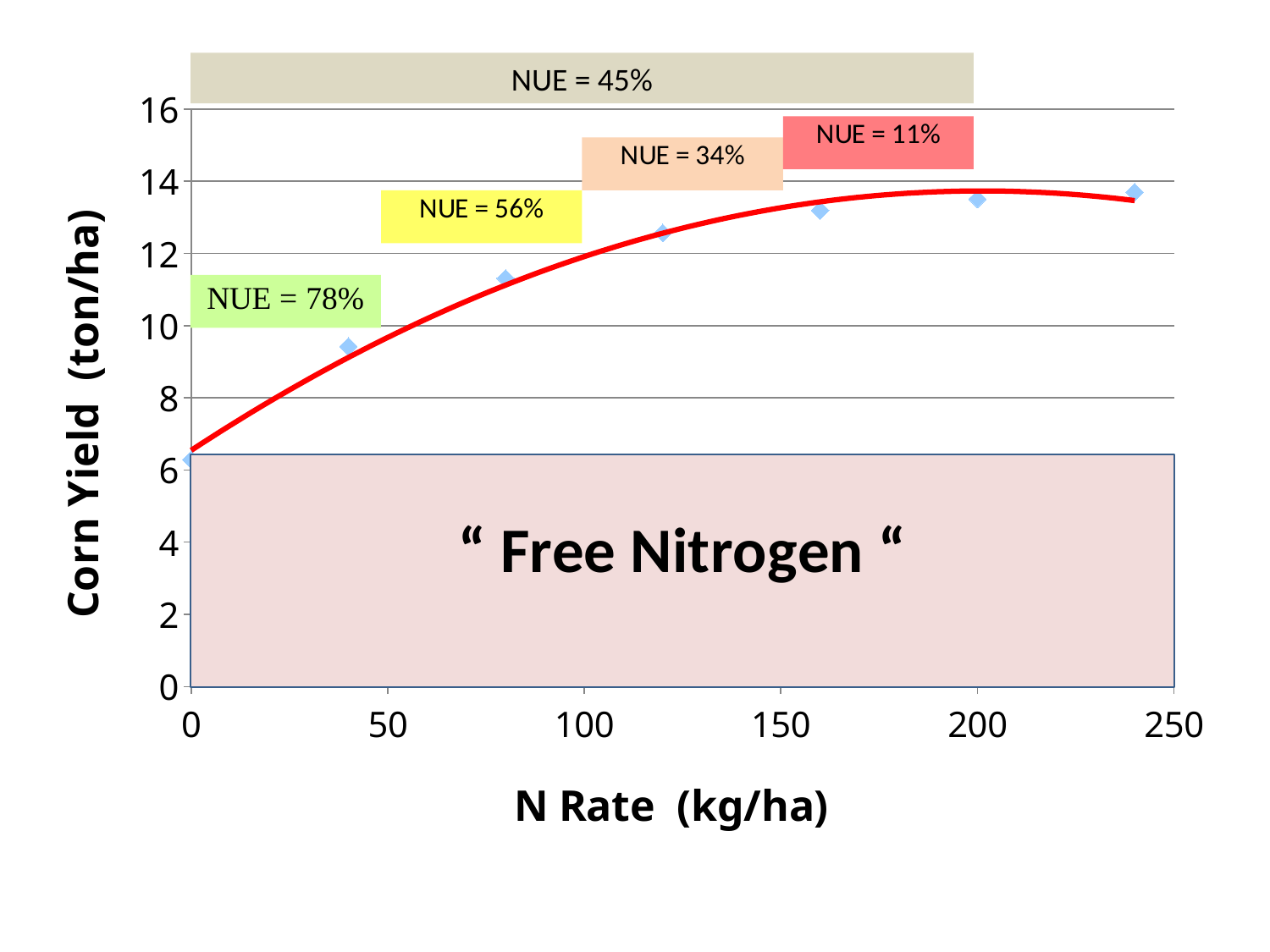
Is the corn yield at an N rate of 80 kg/ha greater or less than 10 ton/ha? greater Is the corn yield at an N rate of 0 kg/ha greater or less than 8 ton/ha? less What kind of chart is shown on the slide? scatter chart with a fitted curve At which N rate is the corn yield lowest? 0 kg/ha What NUE value is shown in the green box at the lowest N rates? NUE = 78% What text is written in the shaded box at the bottom of the chart? "Free Nitrogen" How many data points are plotted on the chart? 7 Does corn yield rise or fall as N rate increases from 0 to 200 kg/ha? rise Is the corn yield at an N rate of 200 kg/ha greater or less than 14 ton/ha? less Which has the higher corn yield: an N rate of 40 kg/ha or 80 kg/ha? 80 kg/ha